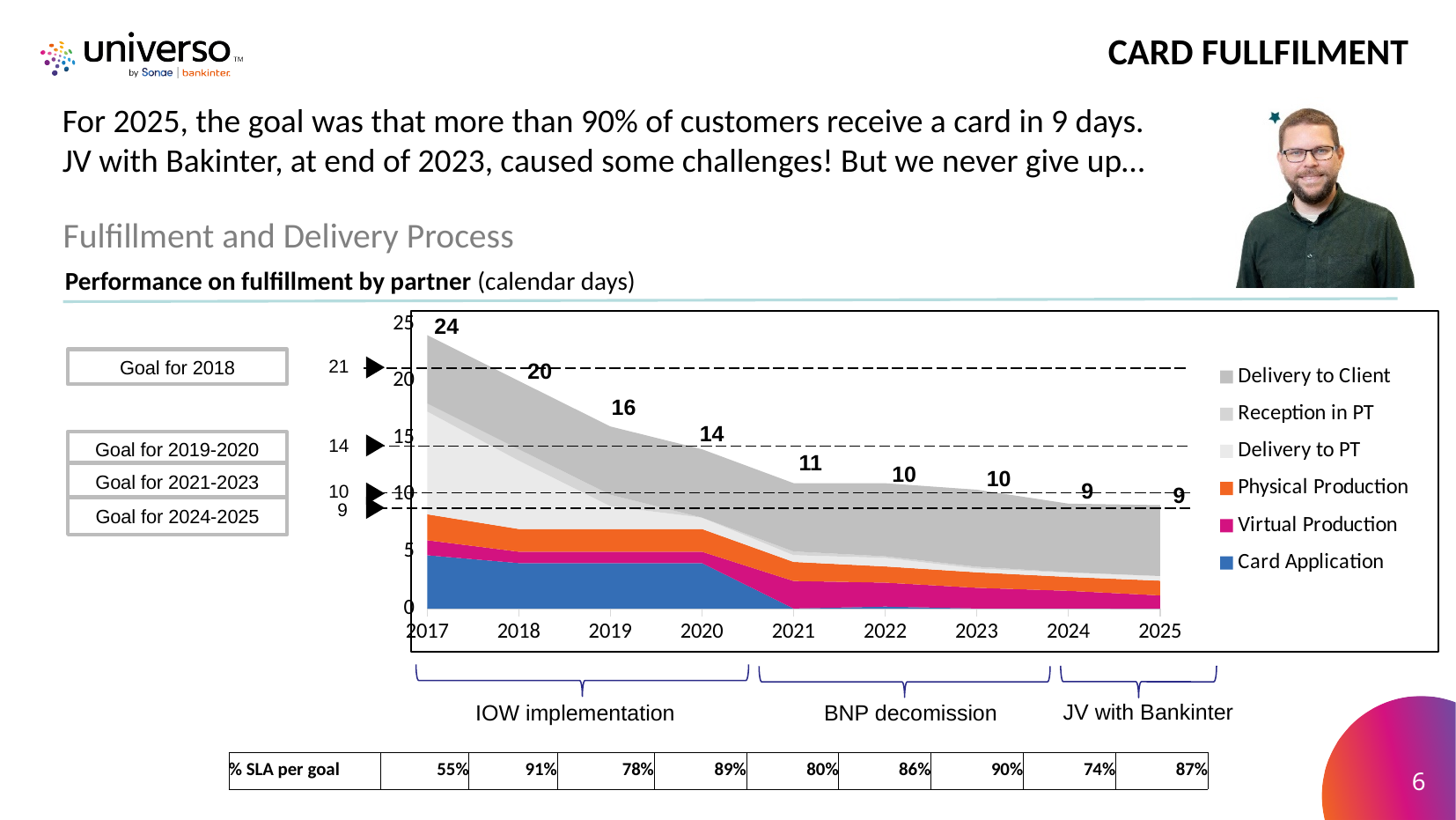
What is the total number of calendar days shown for 2017? 24 Which year has the highest total calendar days? 2017 How many series does the legend list? 6 What is the goal value shown for 2024-2025? 9 Which year has a larger total, 2020 or 2022? 2020 What is the difference in total calendar days between 2017 and 2025? 15 What is the difference in total calendar days between 2018 and 2019? 4 What kind of chart is this? Stacked area chart What is the total number of calendar days shown for 2025? 9 How many years are plotted on the x axis? 9 Do the total calendar days rise or fall from 2017 to 2025? Fall What is the total number of calendar days shown for 2021? 11